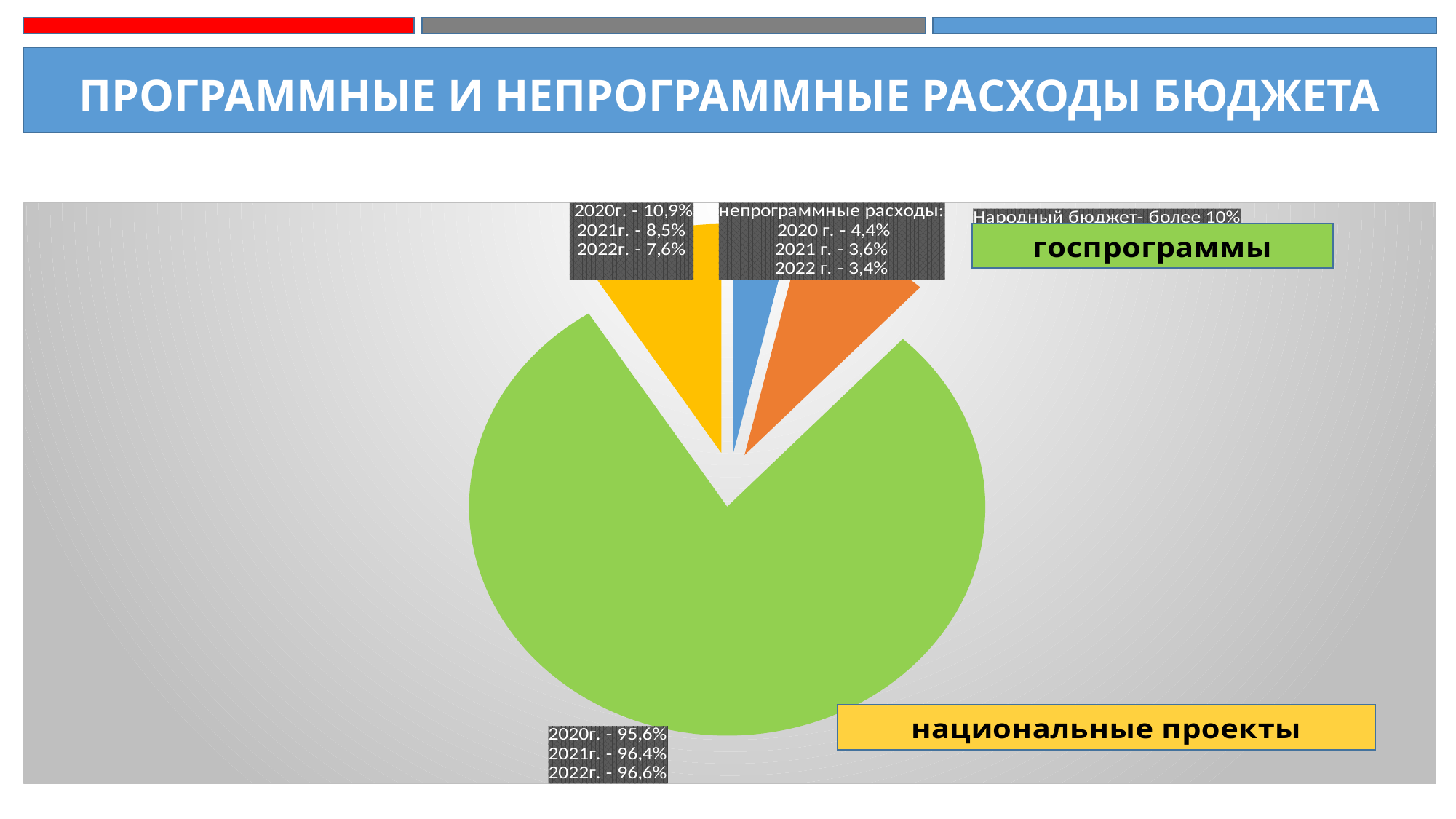
Does the share of госпрограммы rise or fall from 2020 to 2022? rises What share is given for непрограммные расходы in 2021? 3,6% Does the share of непрограммные расходы rise or fall from 2020 to 2022? falls Which is larger: the share of госпрограммы in 2021 or in 2020? 2021 By how many percentage points does the share of непрограммные расходы in 2020 exceed that in 2022? 1,0% What kind of chart is shown on the slide? pie chart What share is given for национальные проекты in 2020? 10,9% Which slice of the pie chart is the largest? госпрограммы (green slice) What share is stated for Народный бюджет on the slide? более 10% By how many percentage points does the share of национальные проекты in 2020 exceed that in 2022? 3,3% What share is given for госпрограммы in 2022? 96,6% What share is given for госпрограммы in 2020? 95,6%